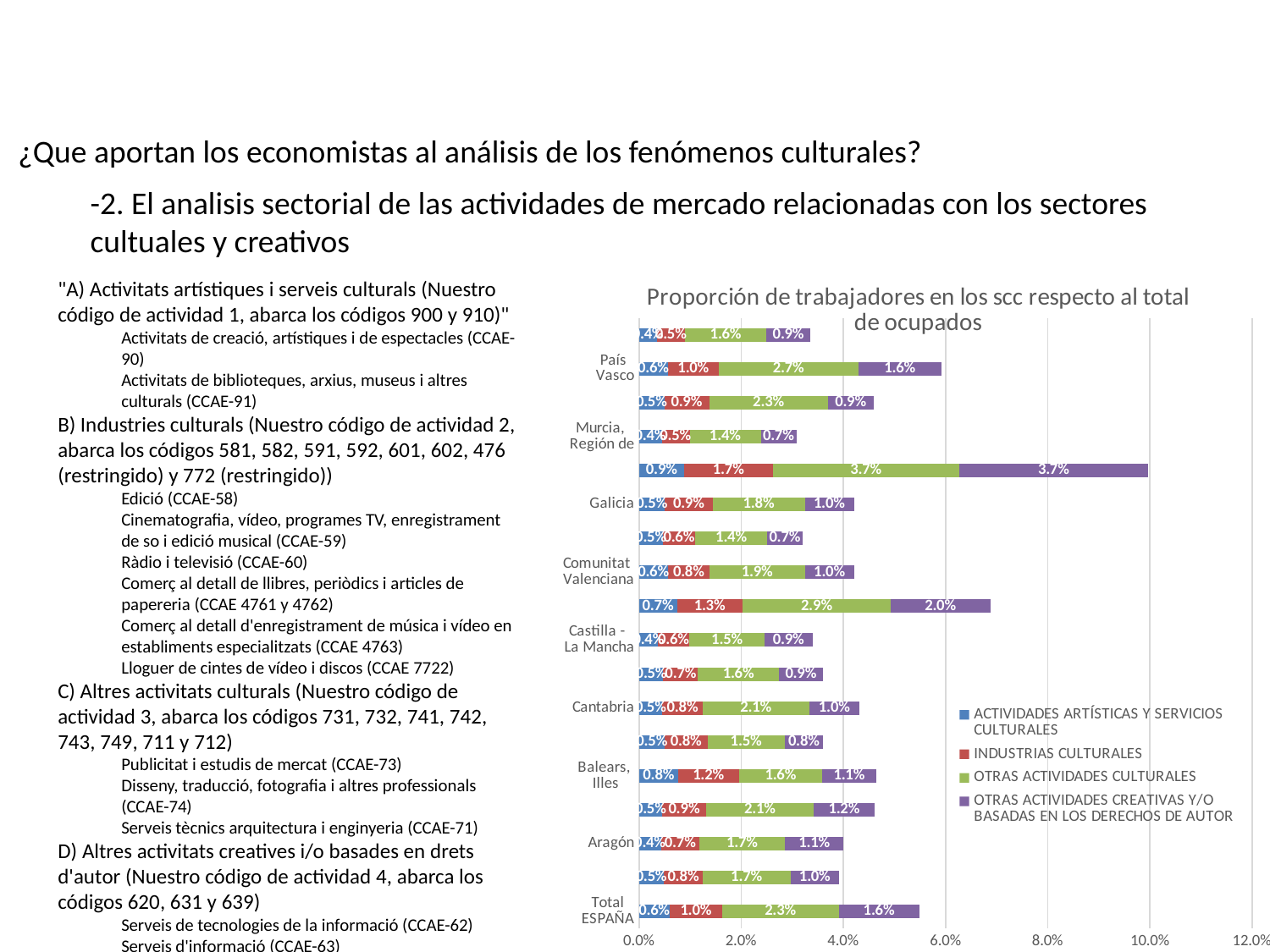
What is the value of OTRAS ACTIVIDADES CULTURALES for País Vasco? 2.7% What is the value of INDUSTRIAS CULTURALES for Aragón? 0.7% How many series does the chart's legend list? 4 Which is larger for OTRAS ACTIVIDADES CULTURALES: País Vasco or Total ESPAÑA? País Vasco What is the total of the stacked bar for Total ESPAÑA? 5.5% What is the difference between the OTRAS ACTIVIDADES CULTURALES values for País Vasco and Total ESPAÑA? 0.4% What is the value of INDUSTRIAS CULTURALES for Total ESPAÑA? 1.0% What is the title of the chart? Proporción de trabajadores en los scc respecto al total de ocupados Which series has the largest value in the Total ESPAÑA bar? OTRAS ACTIVIDADES CULTURALES Which series is shown in green in the chart? OTRAS ACTIVIDADES CULTURALES What is the value of OTRAS ACTIVIDADES CULTURALES for Total ESPAÑA? 2.3% What kind of chart is shown on the slide? Stacked bar chart